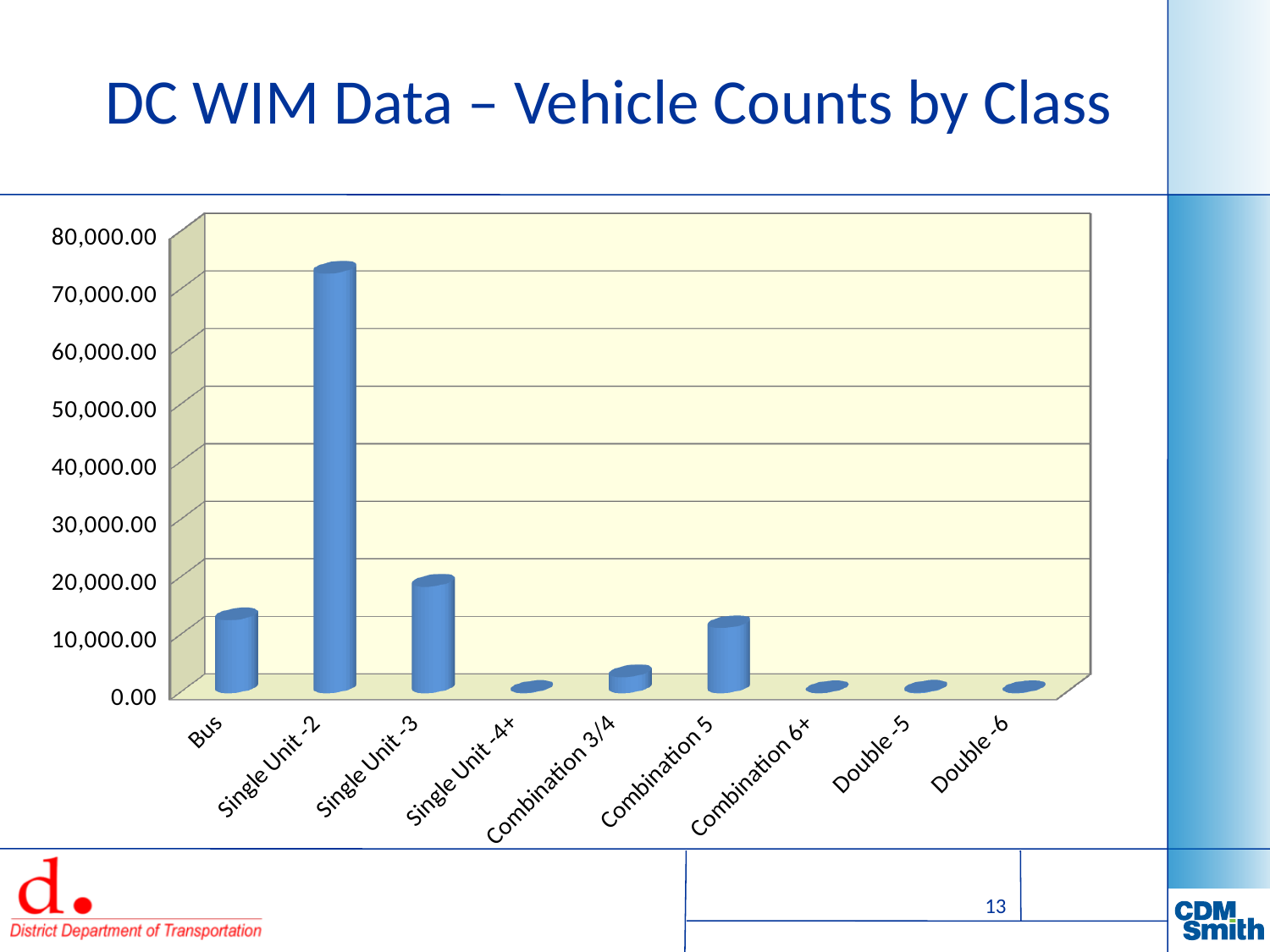
Which vehicle class has the highest count in the chart? Single Unit -2 Which is larger, the value for Single Unit -3 or the value for Bus? Single Unit -3 What is the highest value shown on the chart's vertical axis? 80,000.00 How many vehicle classes are shown on the x axis of the chart? 9 Is the value for Single Unit -2 greater or less than 60,000.00? greater Is the value for Double -5 greater or less than 10,000.00? less What kind of chart is shown on the slide? Bar chart Is the value for Single Unit -3 greater or less than 30,000.00? less Which is larger, the value for Combination 5 or the value for Combination 6+? Combination 5 What is the title of the slide containing the chart? DC WIM Data – Vehicle Counts by Class